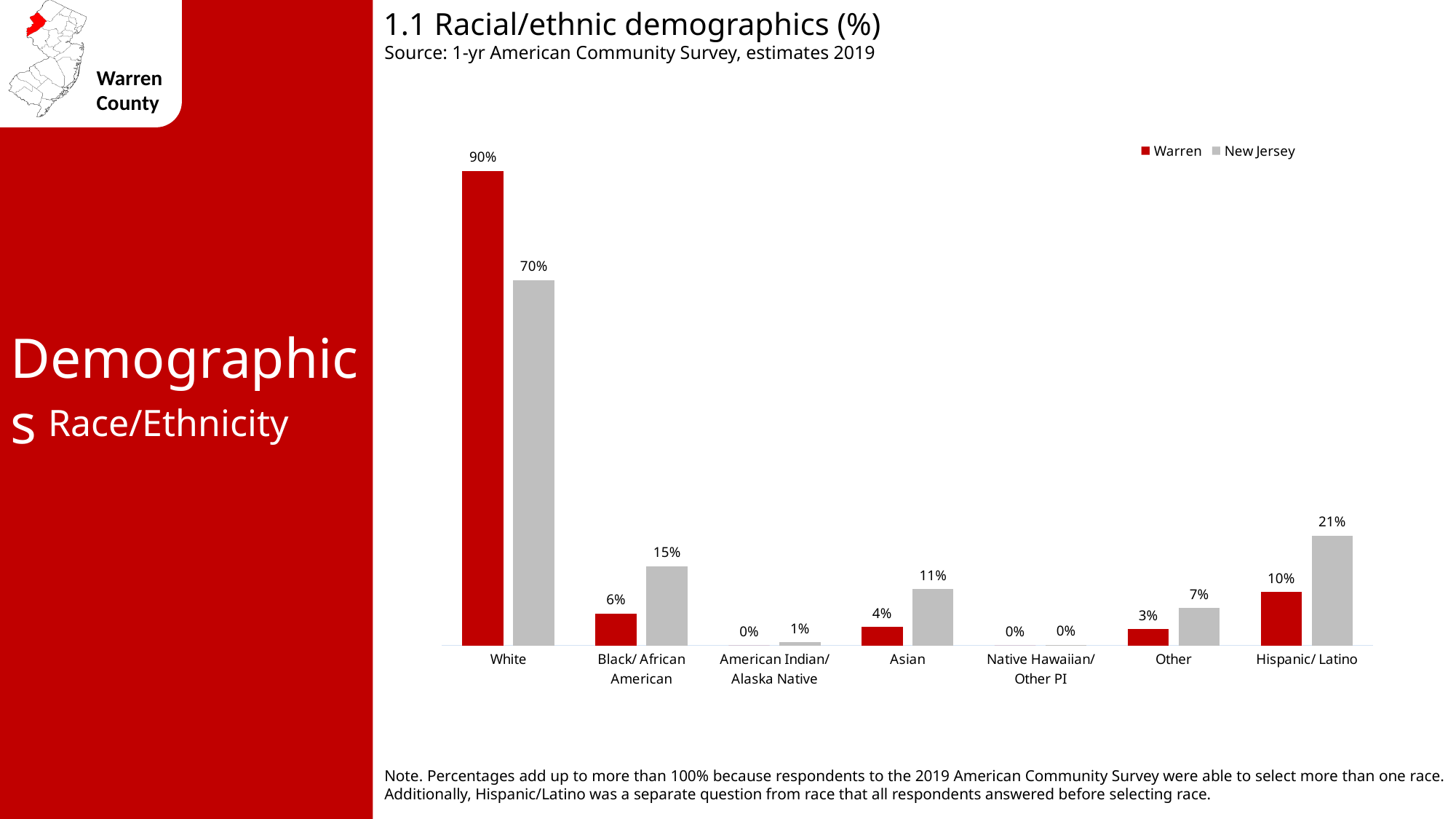
What is the New Jersey value for Black/ African American? 15% Which category has the highest Warren value? White What is the New Jersey value for Hispanic/ Latino? 21% What is the Warren value for Asian? 4% Which category has the lowest New Jersey value? Native Hawaiian/ Other PI How many categories are shown on the x axis? 7 Which is larger for Other: the Warren value or the New Jersey value? New Jersey What is the Warren value for White? 90% What is the difference between the Warren and New Jersey values for White? 20% What kind of chart is shown on the slide? Bar chart How many series does the legend list? 2 What is the difference between the New Jersey and Warren values for Hispanic/ Latino? 11%